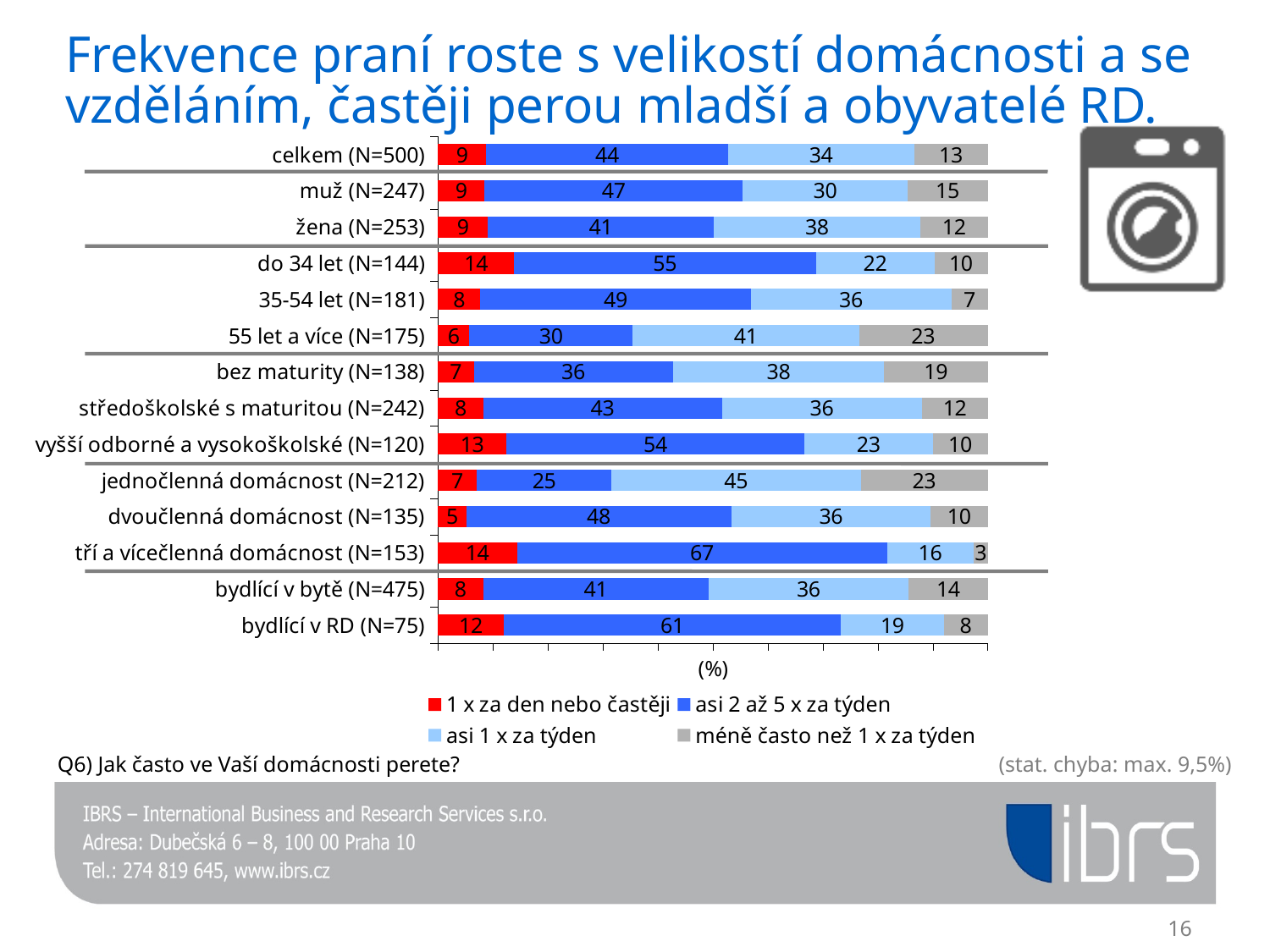
What is the value for "méně často než 1 x za týden" in the "55 let a více (N=175)" bar? 23 What is the total of the stacked bar for "tří a vícečlenná domácnost (N=153)"? 100 How many series does the legend list? 4 Which category has the highest value for "asi 1 x za týden"? jednočlenná domácnost (N=212) What kind of chart is shown on the slide? stacked bar chart Which has the larger value for "1 x za den nebo častěji": "do 34 let (N=144)" or "55 let a více (N=175)"? do 34 let (N=144) What is the value for "asi 2 až 5 x za týden" in the "celkem (N=500)" bar? 44 Which category has the highest value for "asi 2 až 5 x za týden"? tří a vícečlenná domácnost (N=153) What is the difference between "bydlící v RD (N=75)" and "bydlící v bytě (N=475)" for "asi 2 až 5 x za týden"? 20 What is the value for "1 x za den nebo častěji" in the "bydlící v RD (N=75)" bar? 12 How many categories (bars) are shown in the chart? 14 Which category has the lowest value for "1 x za den nebo častěji"? dvoučlenná domácnost (N=135)